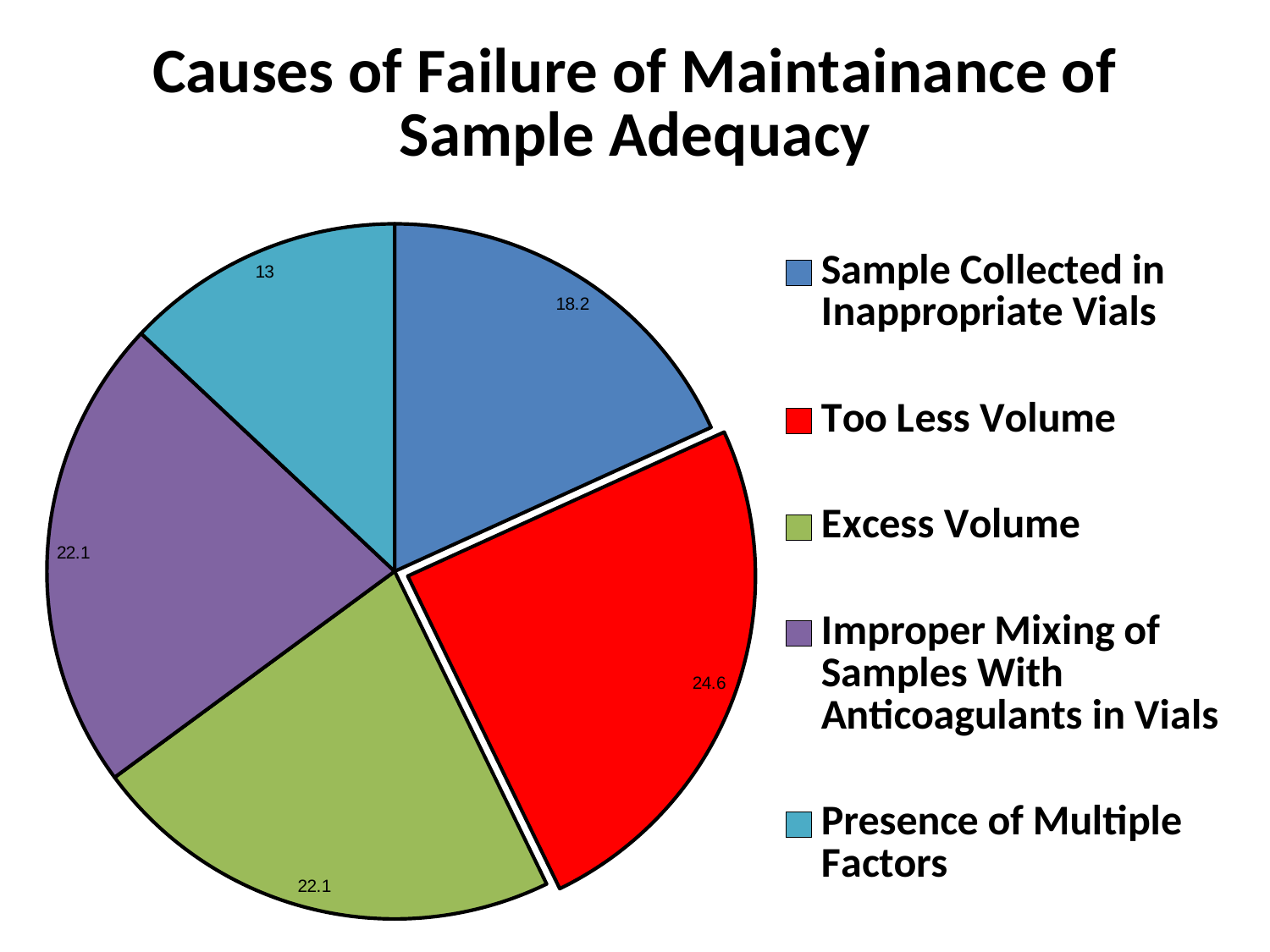
Which is larger, the value for Excess Volume or the value for Presence of Multiple Factors? Excess Volume What value is shown for the Too Less Volume slice? 24.6 What value is shown for the Presence of Multiple Factors slice? 13 Which slice is pulled out (exploded) from the rest of the pie? Too Less Volume How many slices does the pie chart have? 5 What kind of chart is shown on the slide? Pie chart What is the difference between the values for Too Less Volume and Sample Collected in Inappropriate Vials? 6.4 What value is shown for the Excess Volume slice? 22.1 Which cause has the largest slice of the pie? Too Less Volume What value is shown for the Sample Collected in Inappropriate Vials slice? 18.2 Which cause has the smallest slice of the pie? Presence of Multiple Factors What is the difference between the values for Improper Mixing of Samples With Anticoagulants in Vials and Presence of Multiple Factors? 9.1